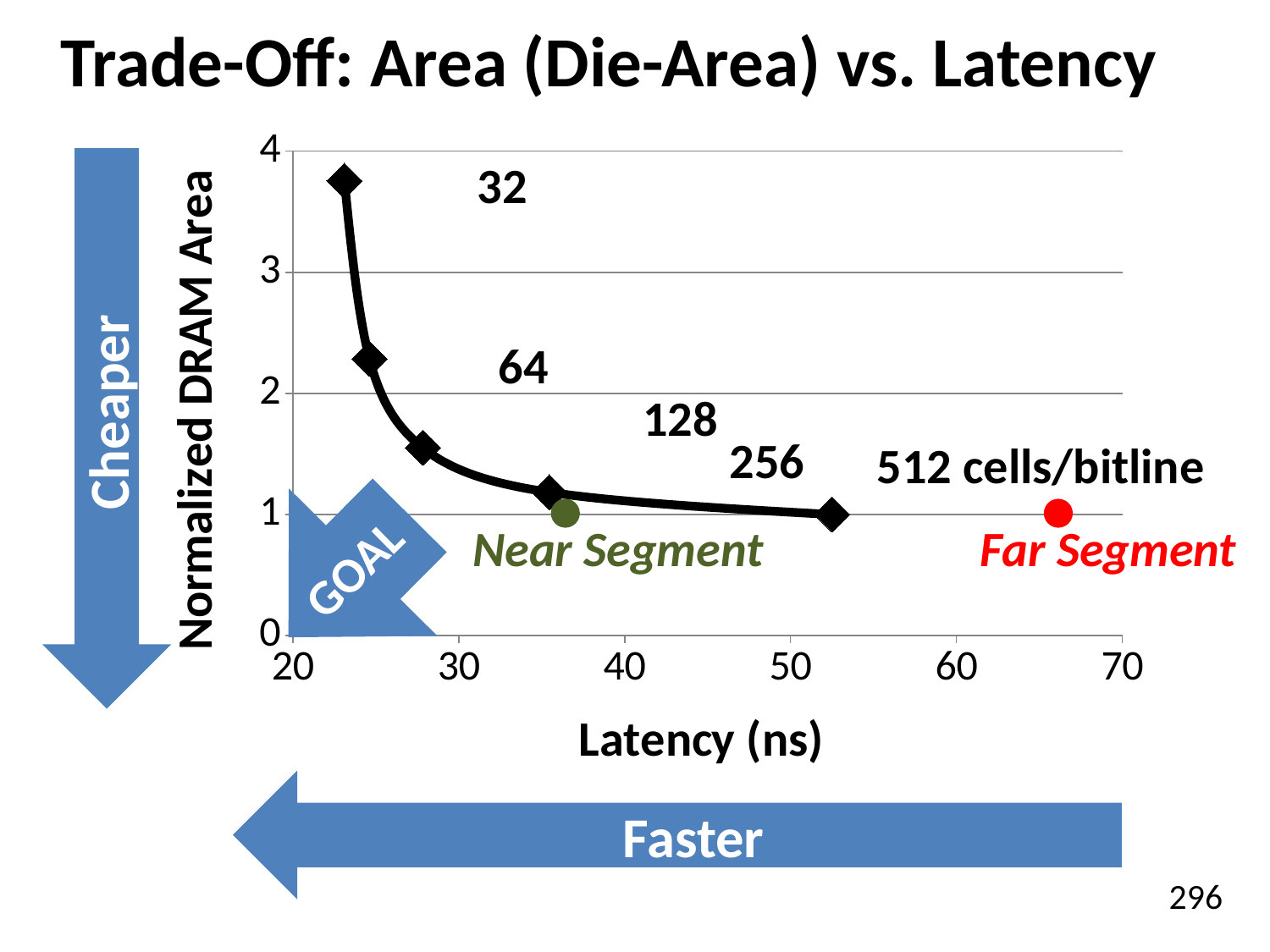
What is the normalized DRAM area for 512 cells/bitline? 1 Which has a larger normalized DRAM area, 64 cells/bitline or 128 cells/bitline? 64 cells/bitline Is the normalized DRAM area for 128 cells/bitline greater or less than 2? less What is the title of the slide's chart? Trade-Off: Area (Die-Area) vs. Latency What is the label of the x axis? Latency (ns) Which cells/bitline configuration has the highest normalized DRAM area? 32 Is the normalized DRAM area for 32 cells/bitline greater or less than 3? greater Is the latency for 512 cells/bitline greater or less than 50 ns? greater How many cells/bitline data points are plotted on the black curve? 5 As latency increases along the x axis, does the normalized DRAM area rise or fall? fall Which cells/bitline configuration has the lowest normalized DRAM area? 512